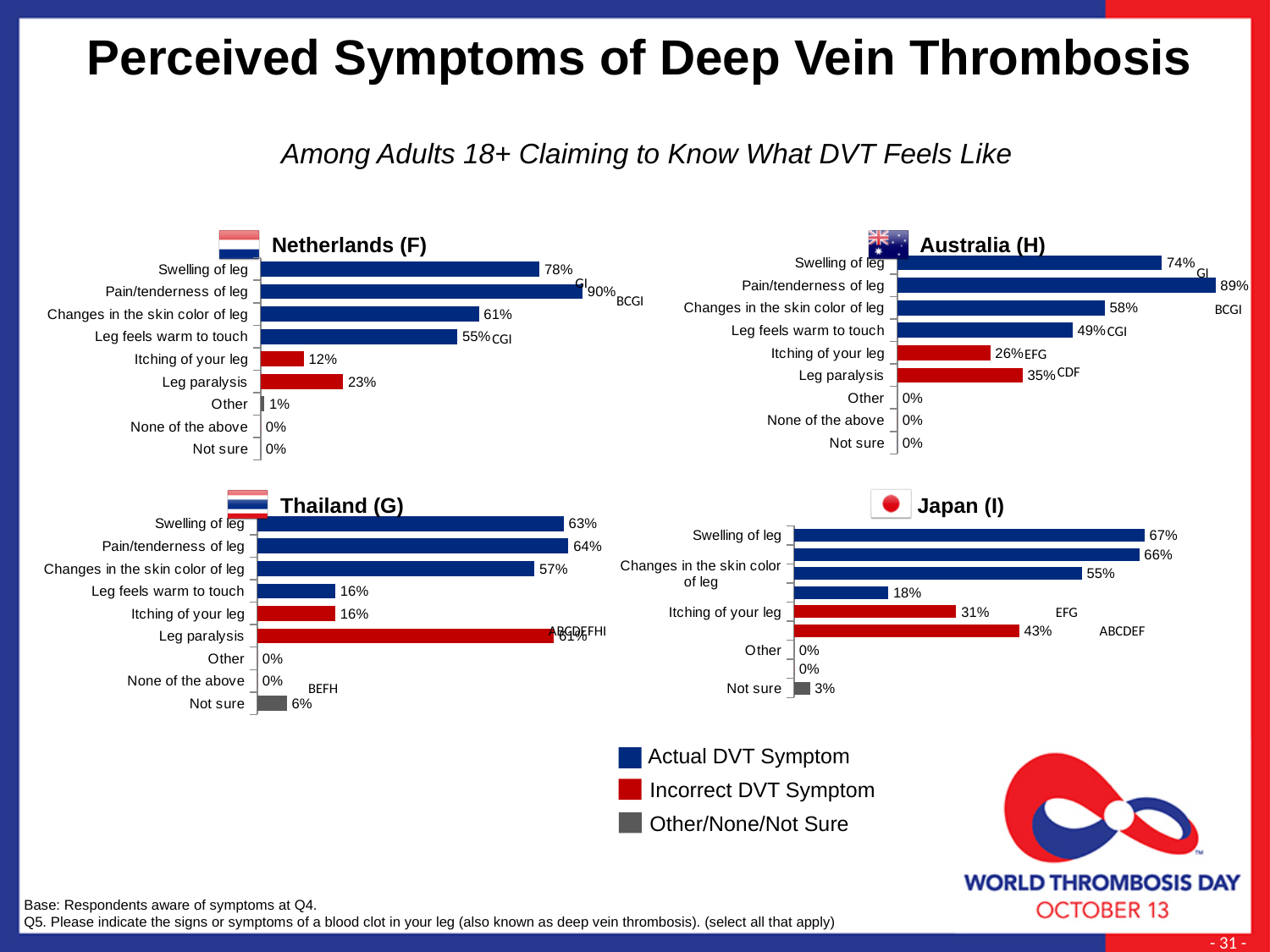
In the Netherlands (F) chart, what is the difference between Swelling of leg and Itching of your leg? 66 percentage points In the Thailand (G) chart, what percentage is shown for Not sure? 6% In the Australia (H) chart, what percentage is shown for Leg paralysis? 35% In the Australia (H) chart, what is the difference between Pain/tenderness of leg and Swelling of leg? 15 percentage points What type of chart is used for the Thailand (G) data? Bar chart In the Japan (I) chart, what percentage is shown for Itching of your leg? 31% How many categories are shown in the Netherlands (F) chart? 9 In the Australia (H) chart, which symptom has the highest percentage? Pain/tenderness of leg In the Netherlands (F) chart, what percentage is shown for Pain/tenderness of leg? 90% Which is larger: Swelling of leg in the Netherlands (F) chart or Swelling of leg in the Australia (H) chart? Netherlands (F) How many series does the legend at the bottom of the slide list? 3 In the Thailand (G) chart, what percentage is shown for Changes in the skin color of leg? 57%